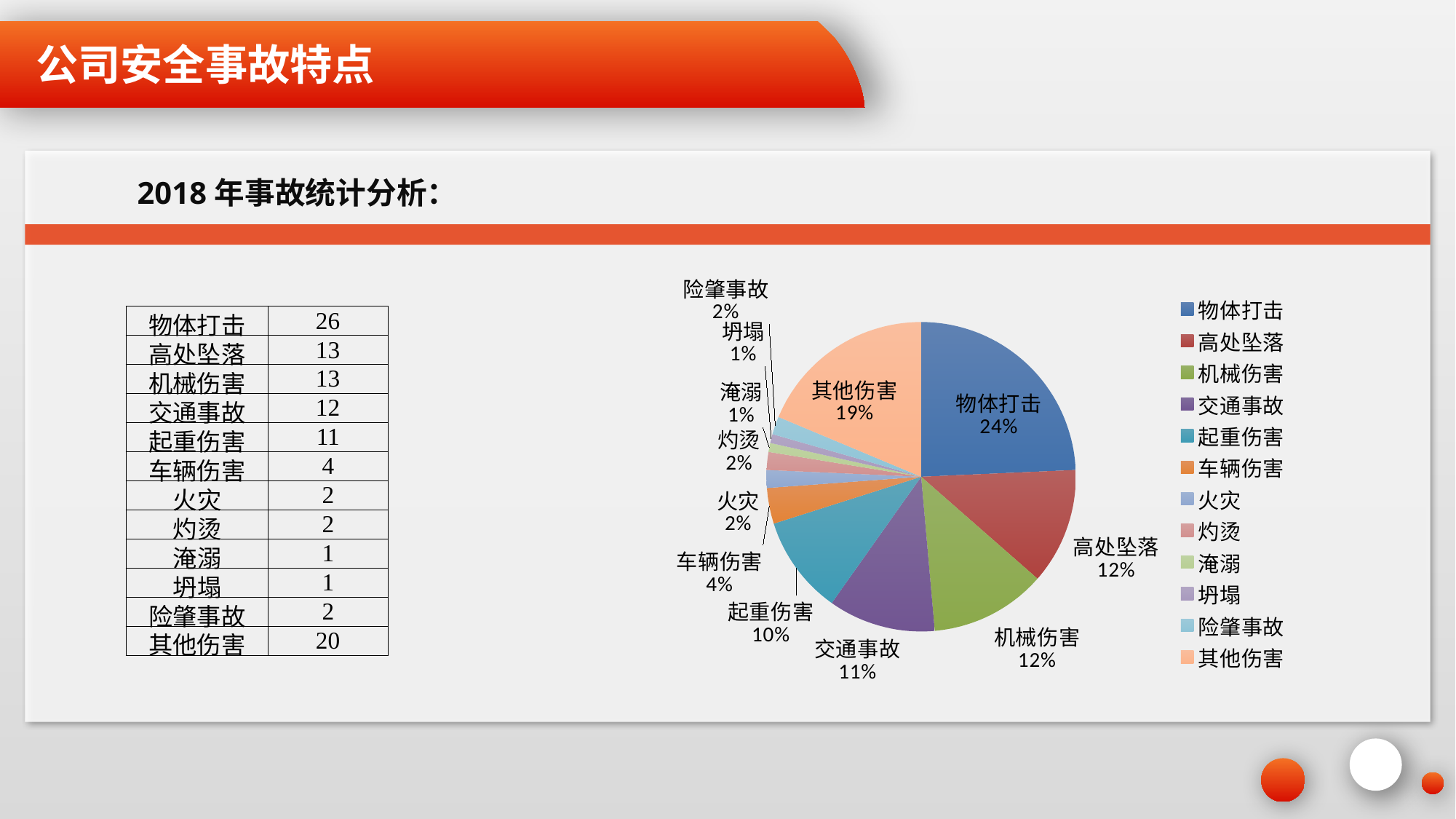
How many categories does the legend of the pie chart list? 12 What percentage is shown for 交通事故 in the pie chart? 11% What percentage is shown for 车辆伤害 in the pie chart? 4% What share of the pie does 其他伤害 represent? 19% Which slice is larger in the pie chart, 起重伤害 or 车辆伤害? 起重伤害 What is the difference in percentage points between 物体打击 and 其他伤害 in the pie chart? 5 What share of the pie does 物体打击 represent? 24% Which category has the largest slice of the pie chart? 物体打击 What colour is the 物体打击 slice in the pie chart? blue What percentage is shown for 起重伤害 in the pie chart? 10% What type of chart is shown on the slide? pie chart What percentage is shown for 高处坠落 in the pie chart? 12%